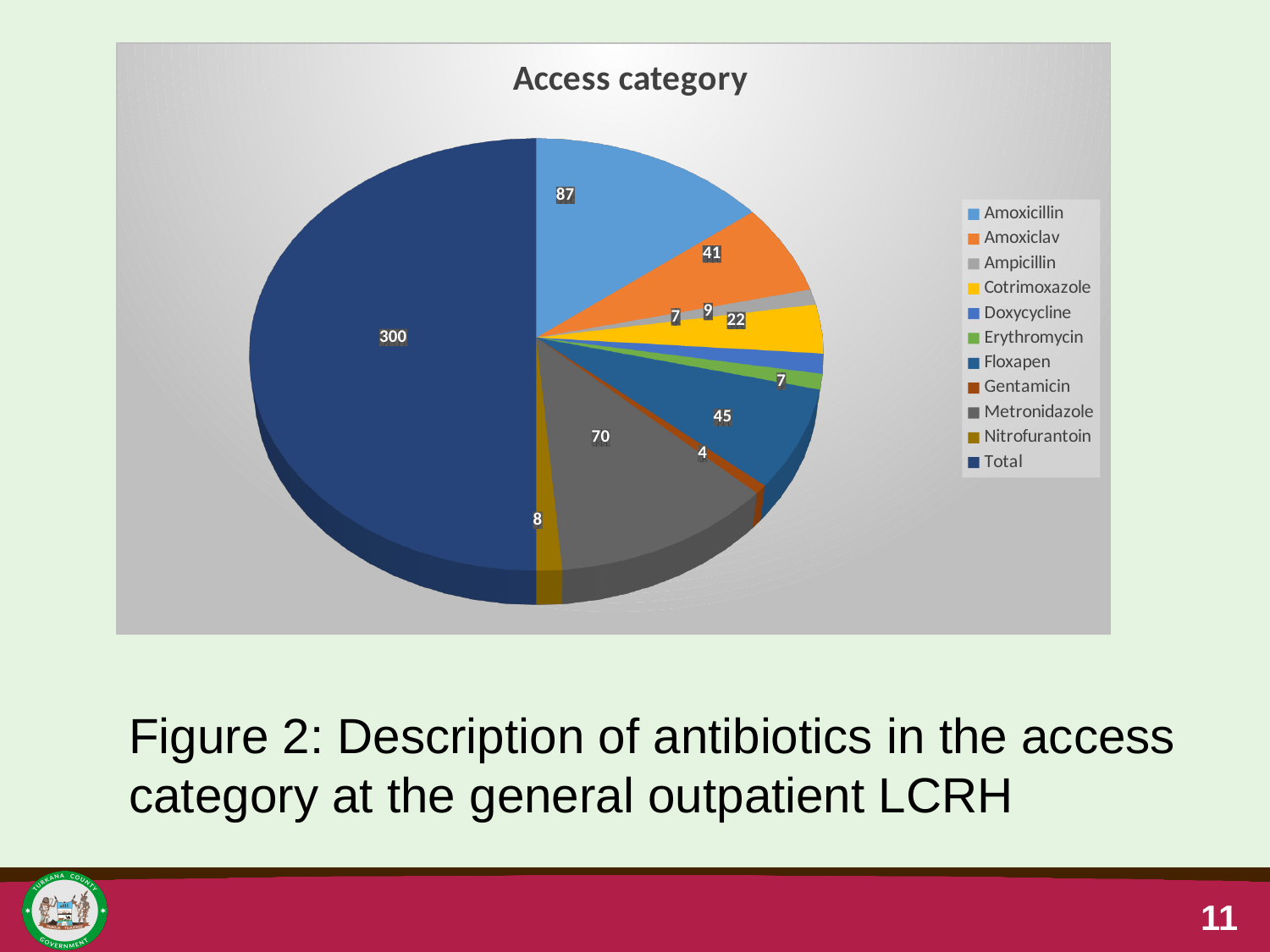
What kind of chart is shown on the slide? pie chart What is the value shown for Amoxicillin? 87 What is the value shown for Metronidazole? 70 What is the value shown for the Total slice? 300 How many entries does the chart legend list? 11 What is the value shown for Cotrimoxazole? 22 What is the title of the chart? Access category What is the value shown for Floxapen? 45 What is the difference between the values for Amoxicillin and Amoxiclav? 46 Which legend entry has the largest slice in the pie? Total Which antibiotic has the smallest slice in the pie? Gentamicin Which is larger, the value for Floxapen or the value for Amoxiclav? Floxapen